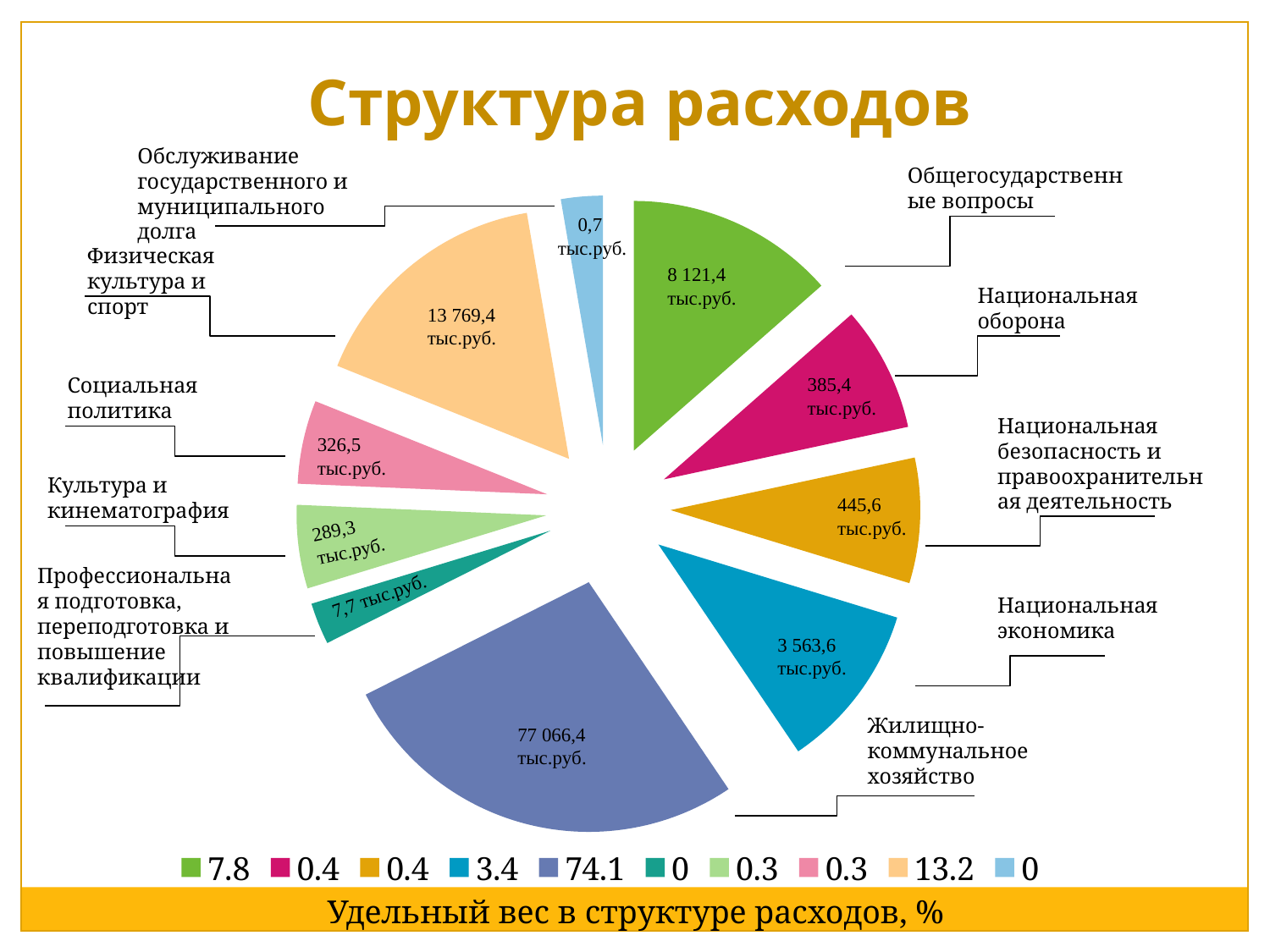
What is the value for Физическая культура и спорт? 13 769,4 тыс.руб. What is the value for Общегосударственные вопросы? 8 121,4 тыс.руб. What is the title of the chart? Структура расходов Which category has the smallest value? Обслуживание государственного и муниципального долга What is the value for Национальная экономика? 3 563,6 тыс.руб. According to the legend, what share in percent does the Жилищно-коммунальное хозяйство slice have? 74.1 Which is larger: Социальная политика or Культура и кинематография? Социальная политика How many categories (slices) does the pie chart have? 10 Which category has the largest slice of the pie? Жилищно-коммунальное хозяйство What type of chart is shown on the slide? pie chart What is the difference between Национальная безопасность и правоохранительная деятельность and Национальная оборона? 60,2 тыс.руб. What is the value for Жилищно-коммунальное хозяйство? 77 066,4 тыс.руб.